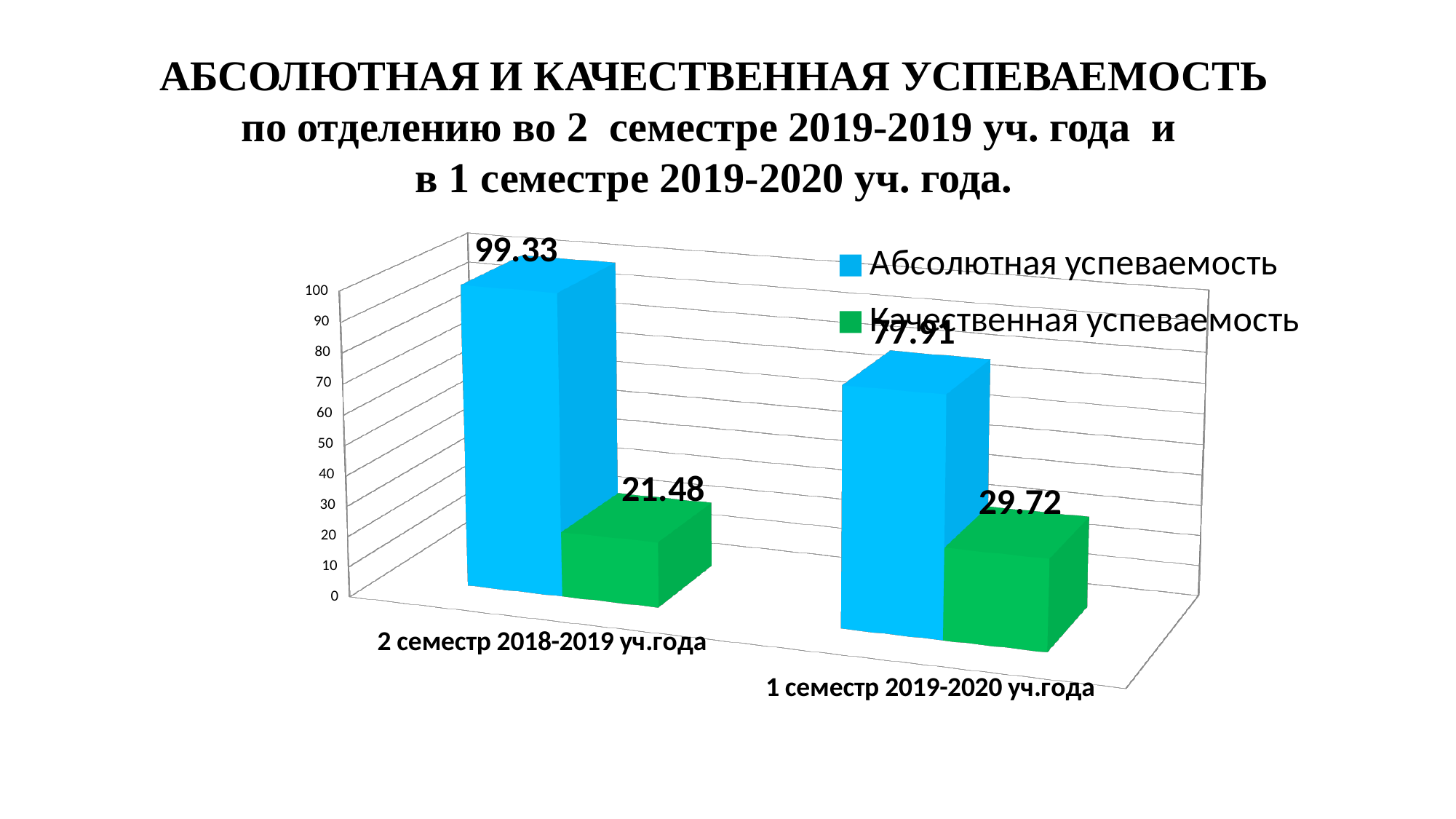
Which colour represents Качественная успеваемость in the chart? Green What is the value of Абсолютная успеваемость for 1 семестр 2019-2020 уч.года? 77.91 What is the value of Качественная успеваемость for 2 семестр 2018-2019 уч.года? 21.48 What is the value of Качественная успеваемость for 1 семестр 2019-2020 уч.года? 29.72 What is the value of Абсолютная успеваемость for 2 семестр 2018-2019 уч.года? 99.33 What is the difference between Абсолютная успеваемость in 2 семестр 2018-2019 уч.года and in 1 семестр 2019-2020 уч.года? 21.42 Which category has the highest value of Абсолютная успеваемость? 2 семестр 2018-2019 уч.года Which category has the lowest value of Качественная успеваемость? 2 семестр 2018-2019 уч.года What kind of chart is shown on the slide? Bar chart How many categories are shown on the x axis of the chart? 2 How many series does the chart legend list? 2 Which is larger: Качественная успеваемость in 2 семестр 2018-2019 уч.года or in 1 семестр 2019-2020 уч.года? 1 семестр 2019-2020 уч.года